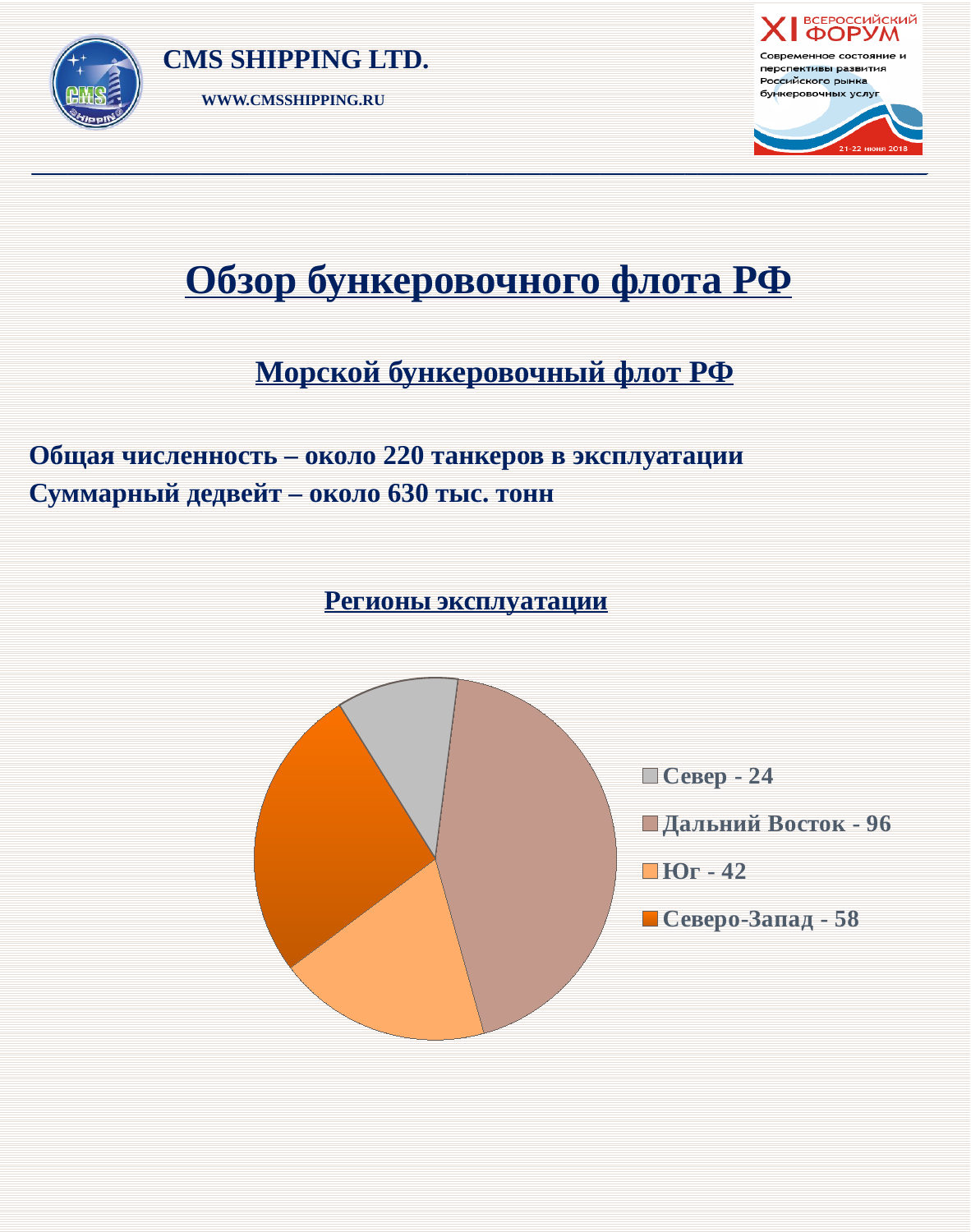
Which region has the largest slice in the pie chart? Дальний Восток What colour is the slice for Север in the pie chart? grey What is the difference between the values for Дальний Восток and Северо-Запад? 38 How many regions (slices) does the pie chart show? 4 What is the value for Север in the pie chart? 24 What is the value for Юг in the pie chart? 42 Which region has the smallest slice in the pie chart? Север Which is larger, the value for Юг or the value for Северо-Запад? Северо-Запад What is the value for Дальний Восток in the pie chart? 96 What is the total of all four values shown in the pie chart legend? 220 What is the value for Северо-Запад in the pie chart? 58 What type of chart is shown under the heading "Регионы эксплуатации"? pie chart